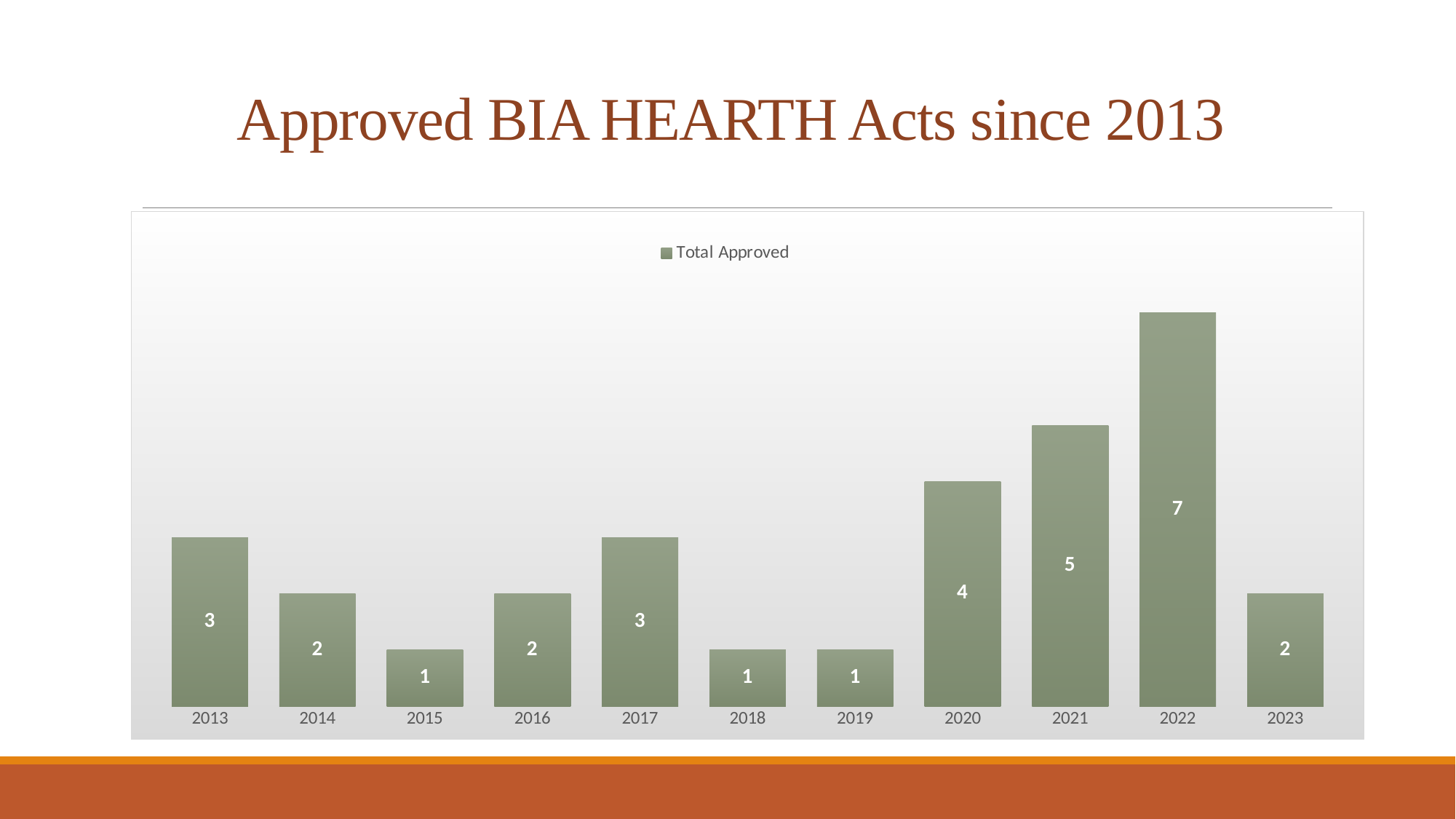
Which is larger, the Total Approved value for 2017 or for 2023? 2017 What kind of chart is shown on the slide? bar chart What is the title of the slide? Approved BIA HEARTH Acts since 2013 What is the Total Approved value for 2020? 4 What is the Total Approved value for 2015? 1 Do the Total Approved values rise or fall from 2019 to 2022? rise What is the Total Approved value for 2022? 7 How many years are shown on the x axis? 11 How many series does the legend list? 1 What is the difference between the Total Approved values for 2022 and 2021? 2 What is the difference between the Total Approved values for 2020 and 2019? 3 Which year has the highest Total Approved value? 2022